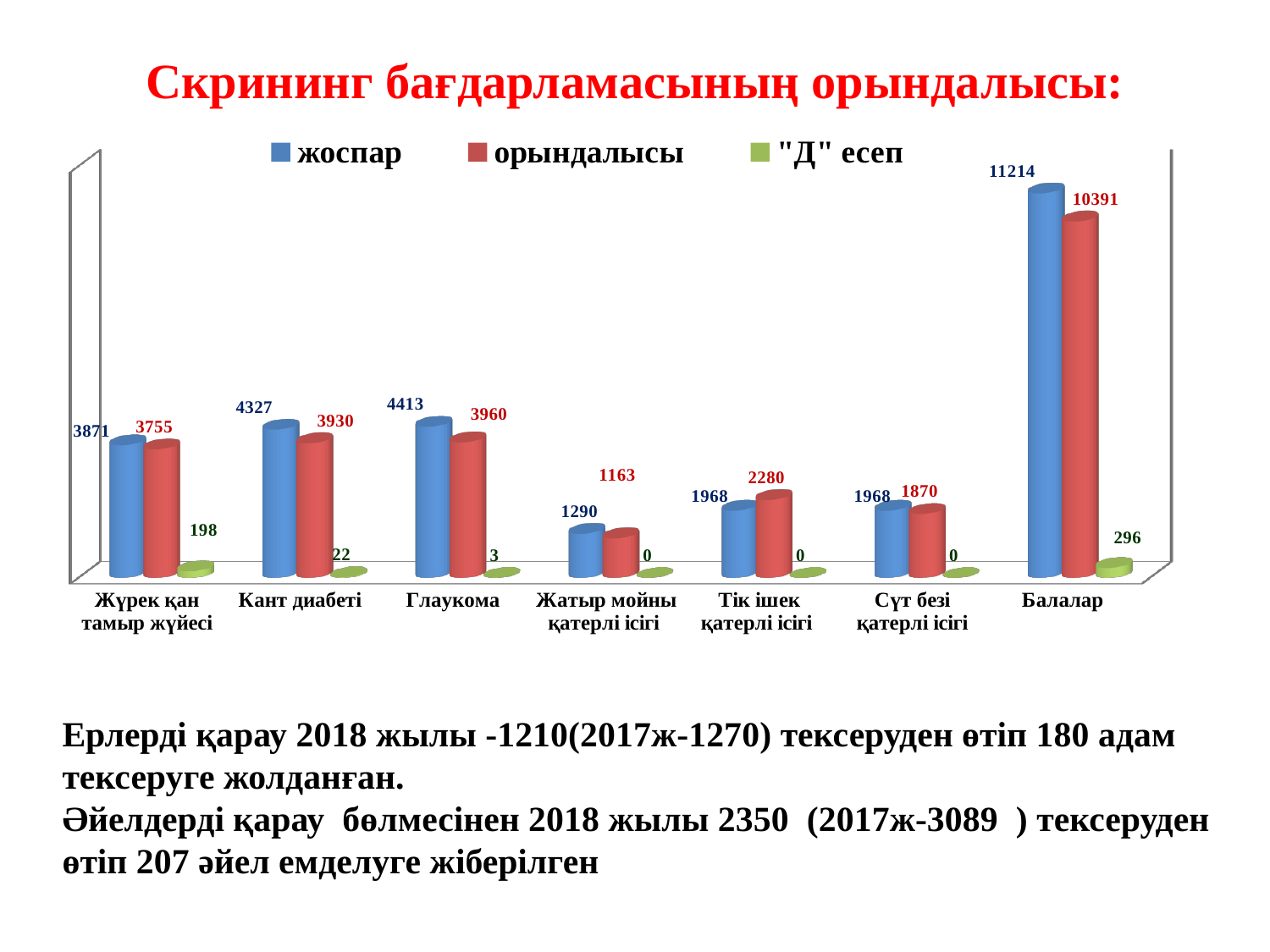
What is the орындалысы value for Глаукома? 3960 How many categories are shown on the x axis? 7 What kind of chart is shown on the slide? bar chart How many series does the legend list? 3 What is the "Д" есеп value for Жүрек қан тамыр жүйесі? 198 Which category has the lowest орындалысы value? Жатыр мойны қатерлі ісігі Which category has the highest жоспар value? Балалар What is the орындалысы value for Тік ішек қатерлі ісігі? 2280 What is the title of the slide? Скрининг бағдарламасының орындалысы: Which is larger for Тік ішек қатерлі ісігі: the жоспар value or the орындалысы value? орындалысы What is the жоспар value for Балалар? 11214 What is the difference between the жоспар and орындалысы values for Балалар? 823